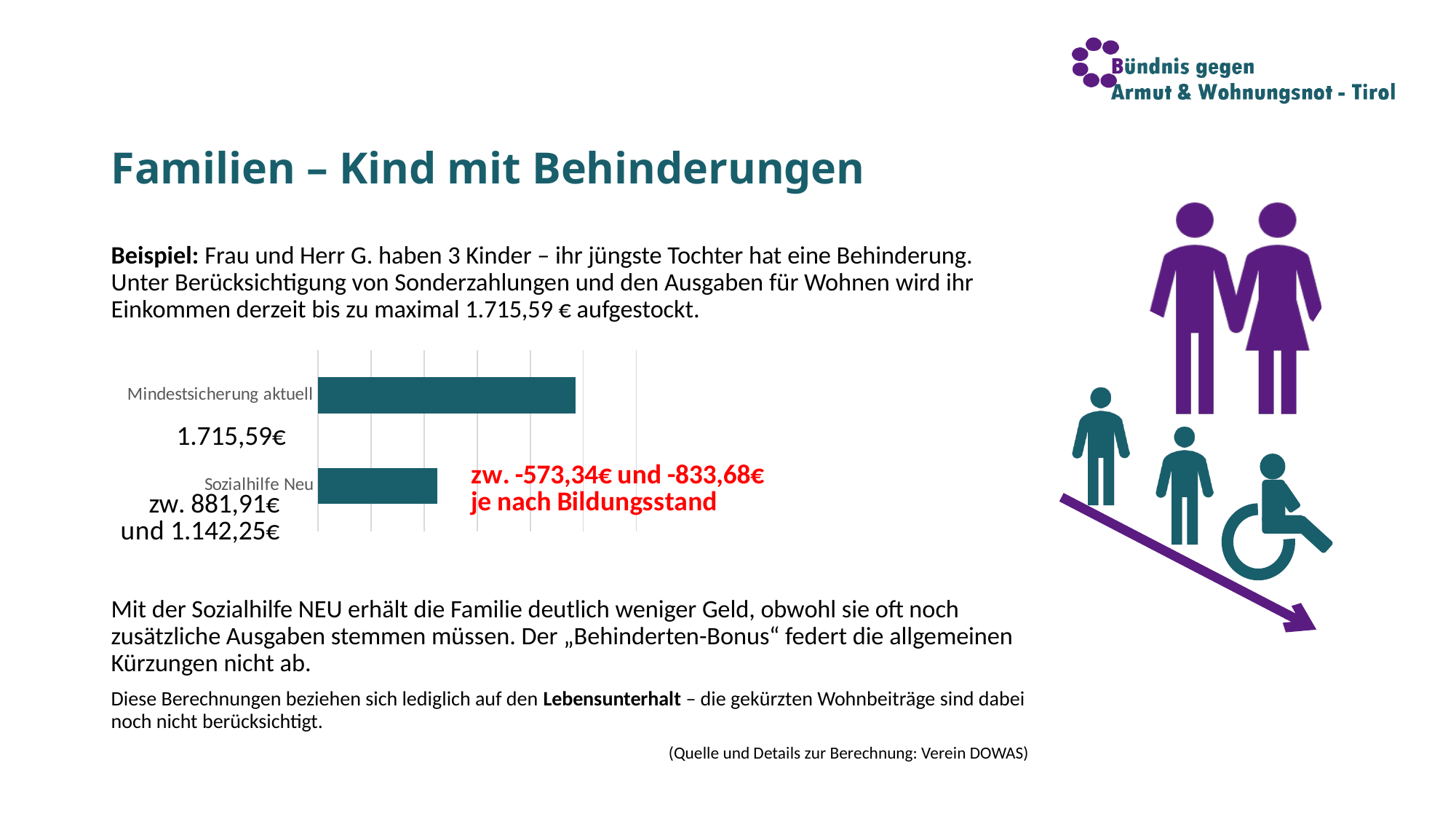
What value range is shown for Sozialhilfe Neu? zw. 881,91€ und 1.142,25€ What colour are the bars in the chart? teal What difference range is printed in red next to the Sozialhilfe Neu bar? zw. -573,34€ und -833,68€ Is the bar for Mindestsicherung aktuell longer or shorter than the bar for Sozialhilfe Neu? longer Which category has the shorter bar? Sozialhilfe Neu What value is shown for Mindestsicherung aktuell? 1.715,59€ Which category has the longer bar? Mindestsicherung aktuell What kind of chart is shown on the slide? bar chart How many categories are plotted in the chart? 2 According to the red annotation, what does the size of the reduction depend on? Bildungsstand